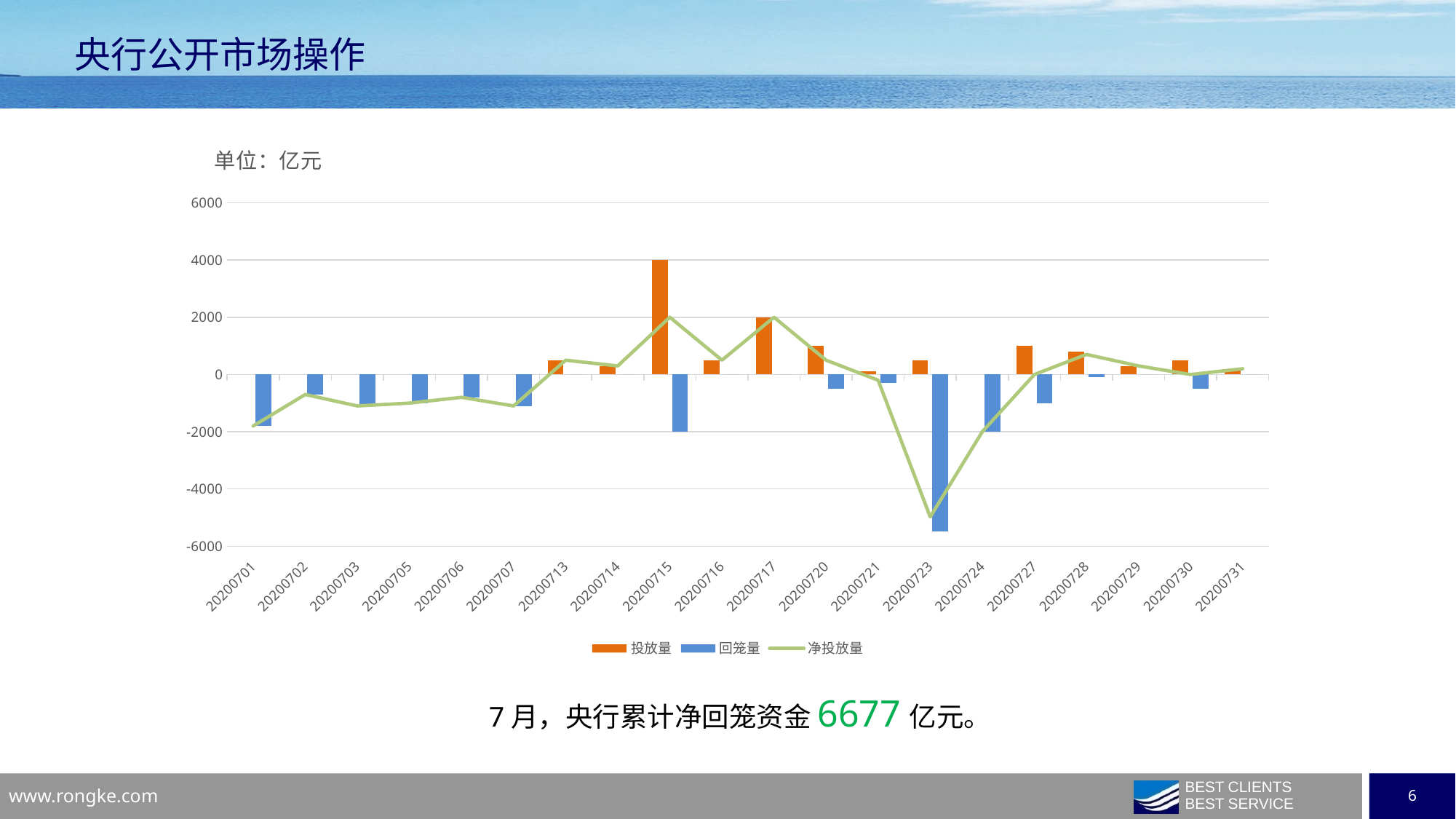
Which series is drawn as a green line in the chart? 净投放量 Is the 回笼量 value for 20200701 greater or less than -1000? less What unit is stated for the chart values? 亿元 How many dates are shown on the x axis of the chart? 20 Is the 投放量 value for 20200715 greater or less than 2000? greater Is the 回笼量 value for 20200723 greater or less than -4000? less How many series does the chart legend list? 3 Which is larger, the 投放量 bar for 20200715 or the 投放量 bar for 20200717? 20200715 What kind of chart is shown on the slide? A combined bar and line chart On which date is the 回笼量 bar the largest (most negative)? 20200723 On which date is the 投放量 bar the highest? 20200715